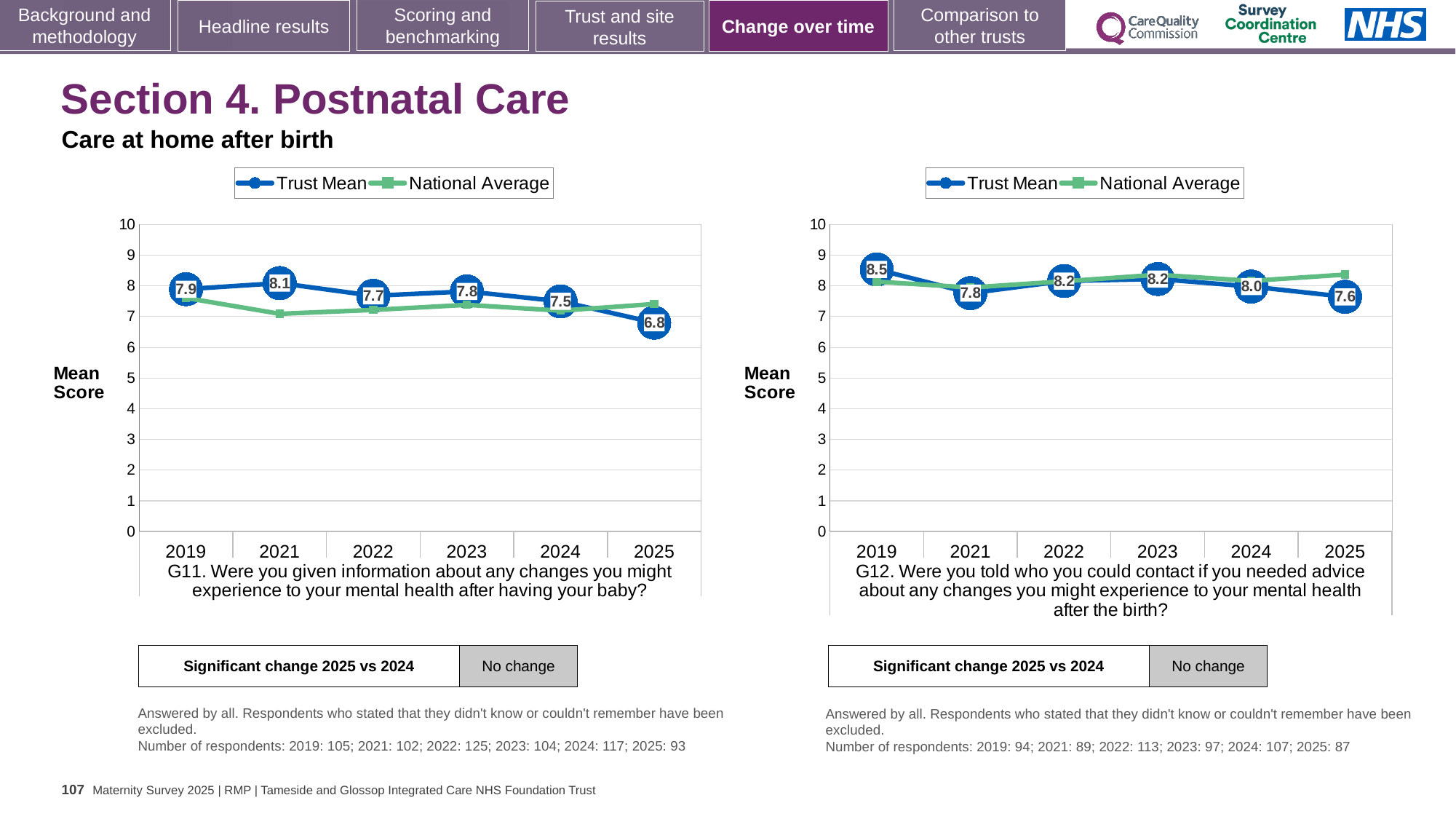
In the G11 chart (left), what is the Trust Mean score for 2021? 8.1 In the G11 chart (left), what is the difference between the Trust Mean scores for 2021 and 2025? 1.3 In the G11 chart (left), is the National Average value for 2021 greater or less than 8? less In the G11 chart (left), which year has the lowest Trust Mean score? 2025 In the G12 chart (right), which year has the highest Trust Mean score? 2019 In the G12 chart (right), is the Trust Mean score for 2024 larger or smaller than the score for 2025? larger In the G12 chart (right), what is the Trust Mean score for 2019? 8.5 In the G11 chart (left), what is the Trust Mean score for 2025? 6.8 In the G12 chart (right), which year has the lowest Trust Mean score? 2025 How many series does the legend of the G12 chart (right) list? 2 In the G11 chart (left), which year has the highest Trust Mean score? 2021 How many years are plotted on the x axis of the G11 chart (left)? 6